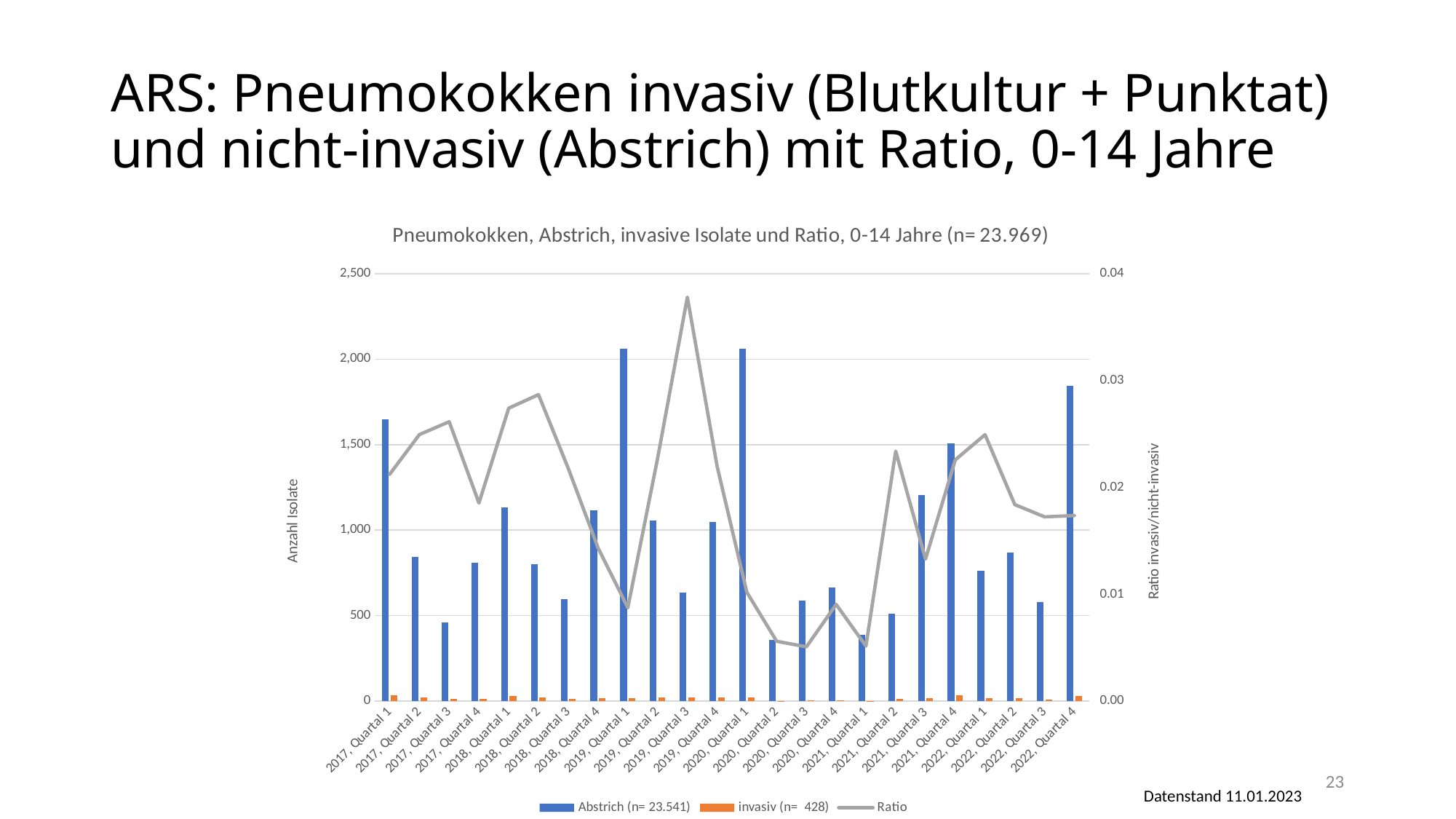
Does the Ratio line rise or fall from 2019, Quartal 3 to 2020, Quartal 3? fall Is the Abstrich value for 2022, Quartal 4 greater or less than 1,500? greater How many quarters are shown along the x axis? 24 Which quarter has the larger Abstrich value, 2017, Quartal 1 or 2017, Quartal 2? 2017, Quartal 1 What is the n value given in the legend for the Abstrich series? 23.541 Is the Abstrich value for 2020, Quartal 2 greater or less than 500? less In which quarter does the Ratio line reach its highest value? 2019, Quartal 3 How many series does the legend list? 3 Is the Abstrich value for 2019, Quartal 1 greater or less than 2,000? greater What kind of chart is shown on the slide? A combination bar and line chart